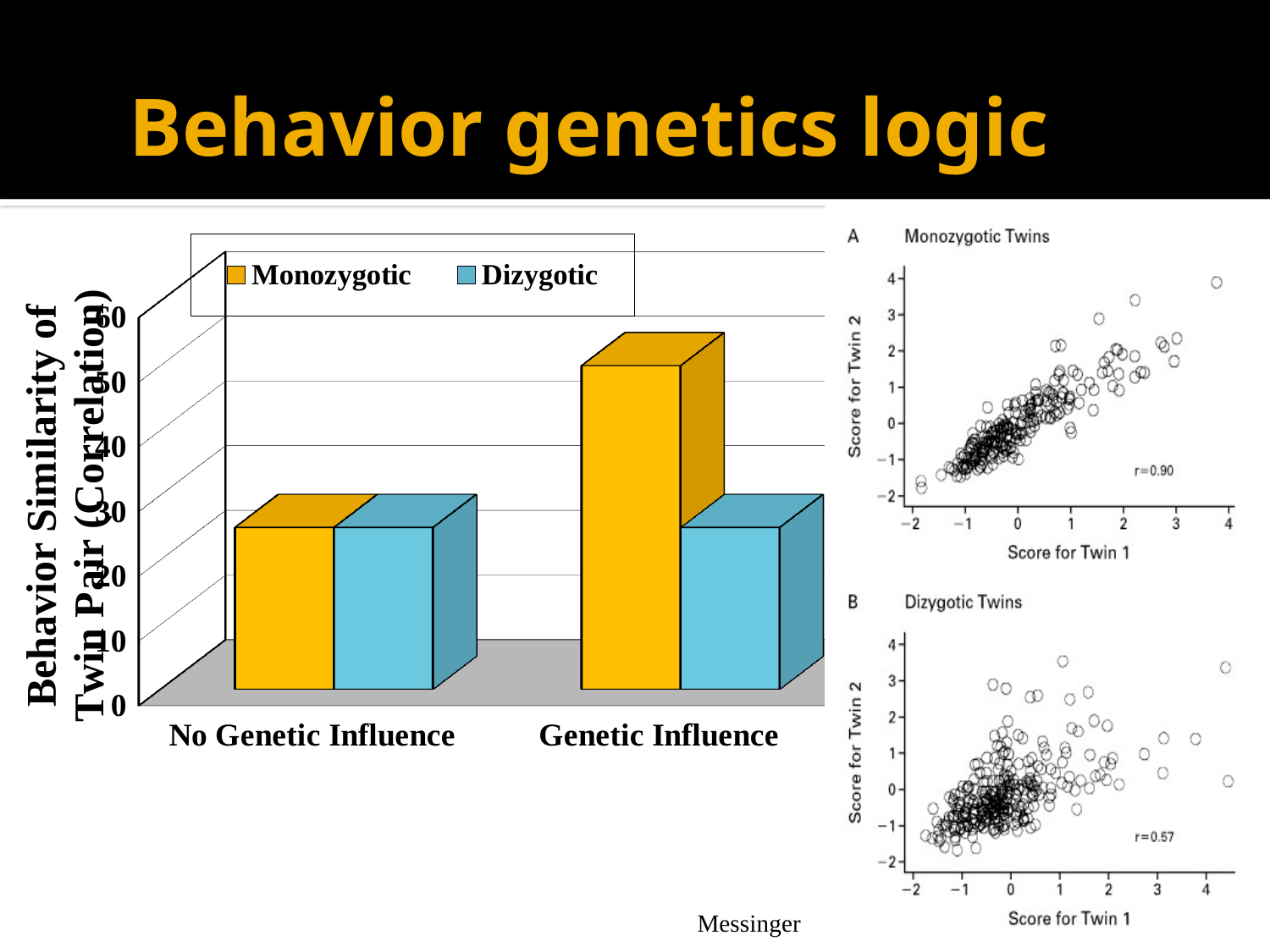
In the bar chart on the left, for Genetic Influence, which is larger: the Monozygotic or the Dizygotic value? Monozygotic What kind of chart is the chart on the left of the slide? bar chart In the bar chart on the left, is the Dizygotic value for Genetic Influence greater or less than 40? less In the bar chart on the left, is the Monozygotic value for Genetic Influence greater or less than 40? greater In the Monozygotic Twins scatter plot on the right, what correlation value (r) is printed? r=0.90 In the bar chart on the left, what colour are the Dizygotic bars? blue In the Dizygotic Twins scatter plot on the right, what correlation value (r) is printed? r=0.57 In the bar chart on the left, how many categories are shown on the x axis? 2 In the bar chart on the left, what is the y-axis title? Behavior Similarity of Twin Pair (Correlation) In the bar chart on the left, which series and category has the tallest bar? Monozygotic, Genetic Influence In the bar chart on the left, is the Monozygotic value for No Genetic Influence greater or less than 40? less In the bar chart on the left, how many series does the legend list? 2